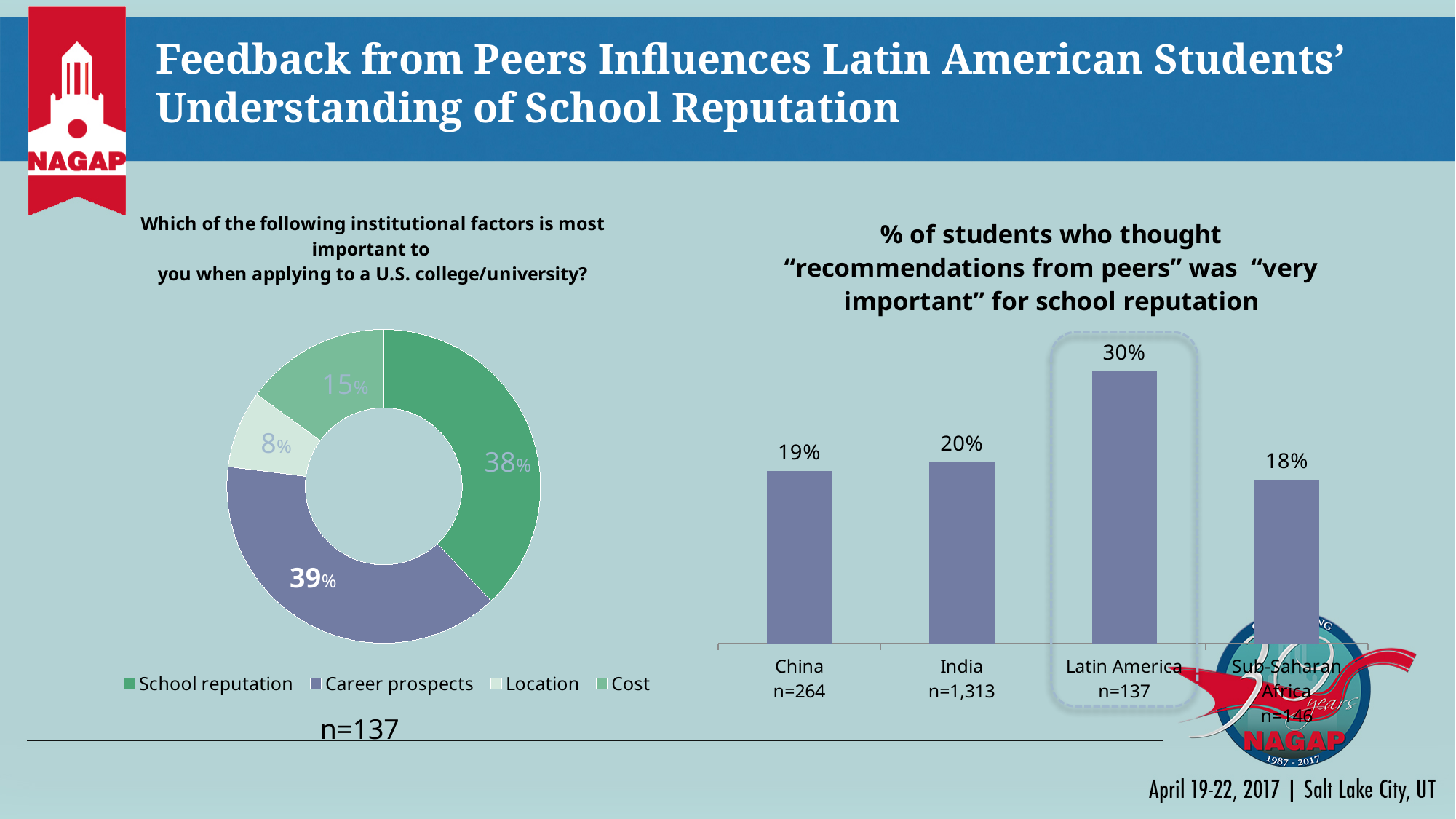
In the right chart, what percentage of Latin American students thought recommendations from peers was very important for school reputation? 30% What kind of chart is the right chart? Bar chart In the left chart, which institutional factor has the smallest share? Location In the right chart, which region has the lowest value? Sub-Saharan Africa In the left chart, what percentage of students chose Career prospects as the most important institutional factor? 39% In the right chart, which region has the highest value? Latin America What kind of chart is the left chart? Pie (donut) chart In the left chart, what is the difference between the Cost share and the Location share? 7% In the left chart, how many categories does the legend list? 4 In the left chart, what share of the pie is Location? 8% In the right chart, what is the difference between the values for Latin America and India? 10% In the right chart, which is larger, the value for China or the value for Sub-Saharan Africa? China